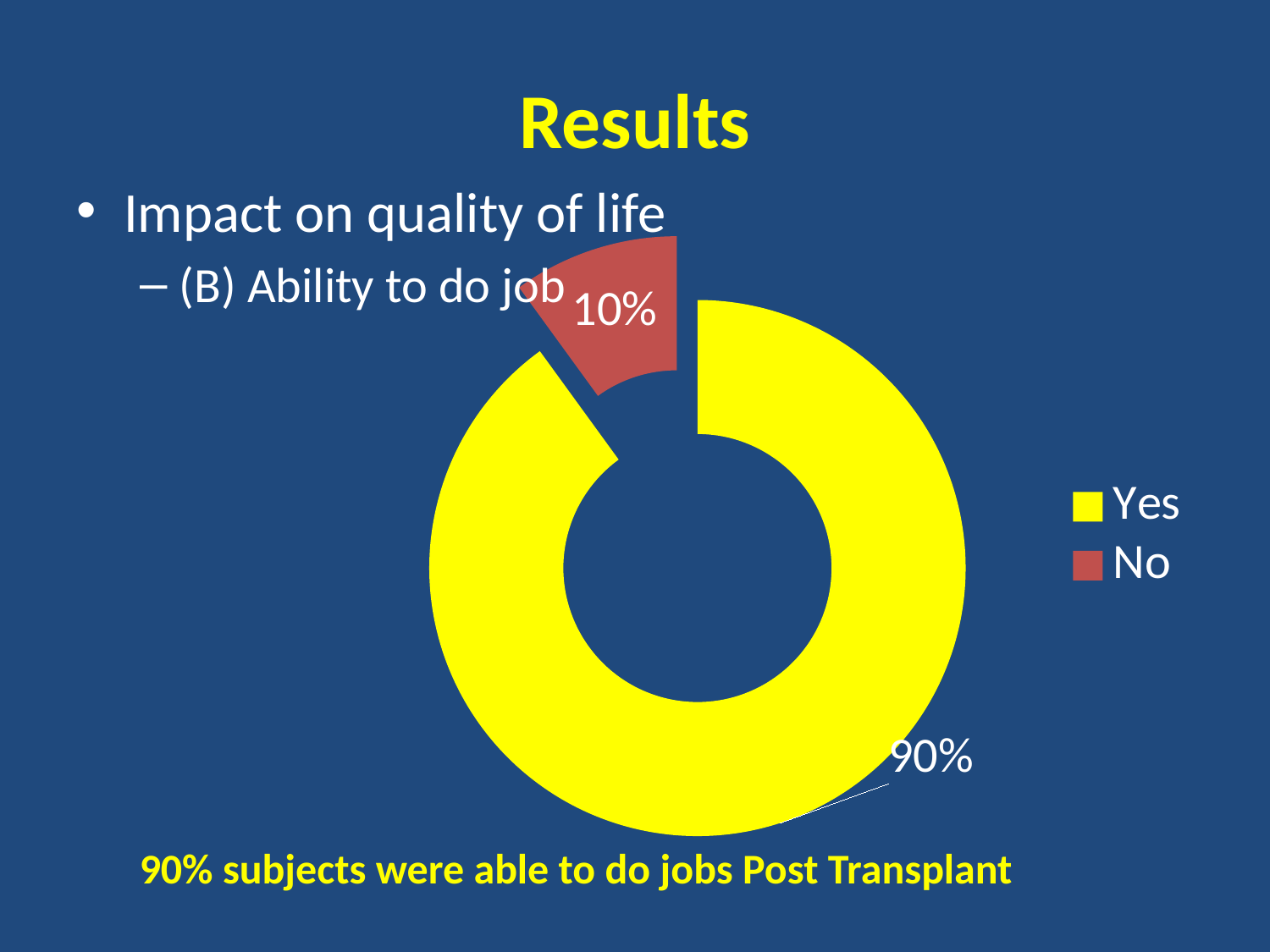
Which category has the smallest share of the chart? No What percentage of subjects answered Yes to being able to do their job? 90% What colour represents the No category? Red What share of the chart does the Yes slice take up? 90% How many categories does the chart show? 2 How many entries does the legend list? 2 Which category has the largest share of the chart? Yes Which is larger, the Yes slice or the No slice? Yes What percentage of subjects answered No to being able to do their job? 10% What is the difference in percentage points between the Yes and No slices? 80 What colour represents the Yes category? Yellow What kind of chart is shown on the slide? Doughnut chart